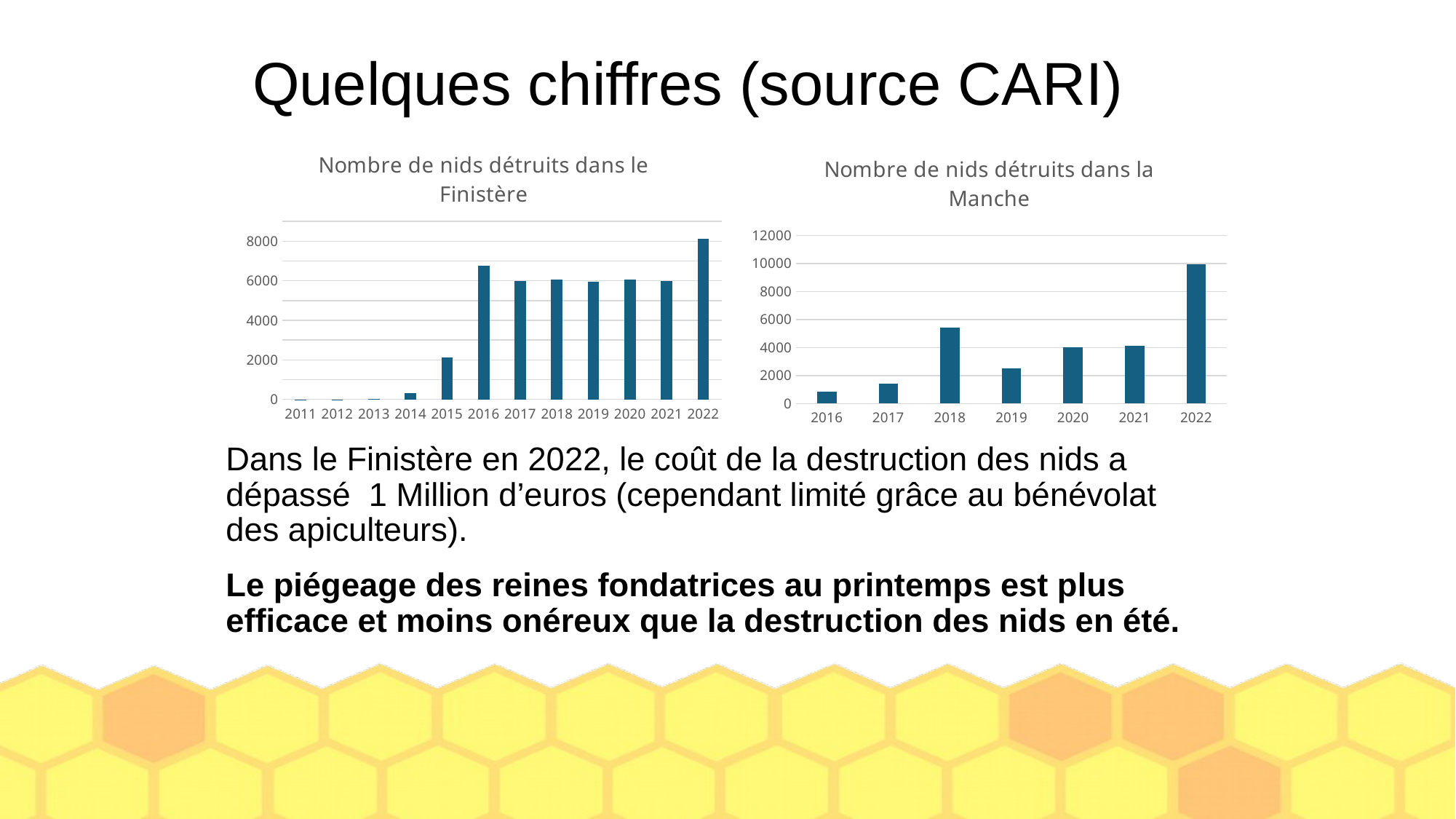
In the "Nombre de nids détruits dans la Manche" chart, is the value for 2018 greater or less than 4000? greater In the "Nombre de nids détruits dans la Manche" chart, which is larger, the value for 2018 or the value for 2019? 2018 In the "Nombre de nids détruits dans la Manche" chart, which year has the lowest value? 2016 In the "Nombre de nids détruits dans la Manche" chart, which year has the highest value? 2022 What kind of chart is "Nombre de nids détruits dans le Finistère"? bar chart In the "Nombre de nids détruits dans le Finistère" chart, is the value for 2017 greater or less than 4000? greater What is the title of the chart on the right of the slide? Nombre de nids détruits dans la Manche In the "Nombre de nids détruits dans le Finistère" chart, which is larger, the value for 2016 or the value for 2015? 2016 How many years are shown on the x axis of the "Nombre de nids détruits dans la Manche" chart? 7 In the "Nombre de nids détruits dans le Finistère" chart, which year has the highest value? 2022 How many years are shown on the x axis of the "Nombre de nids détruits dans le Finistère" chart? 12 In the "Nombre de nids détruits dans le Finistère" chart, is the value for 2014 greater or less than 2000? less